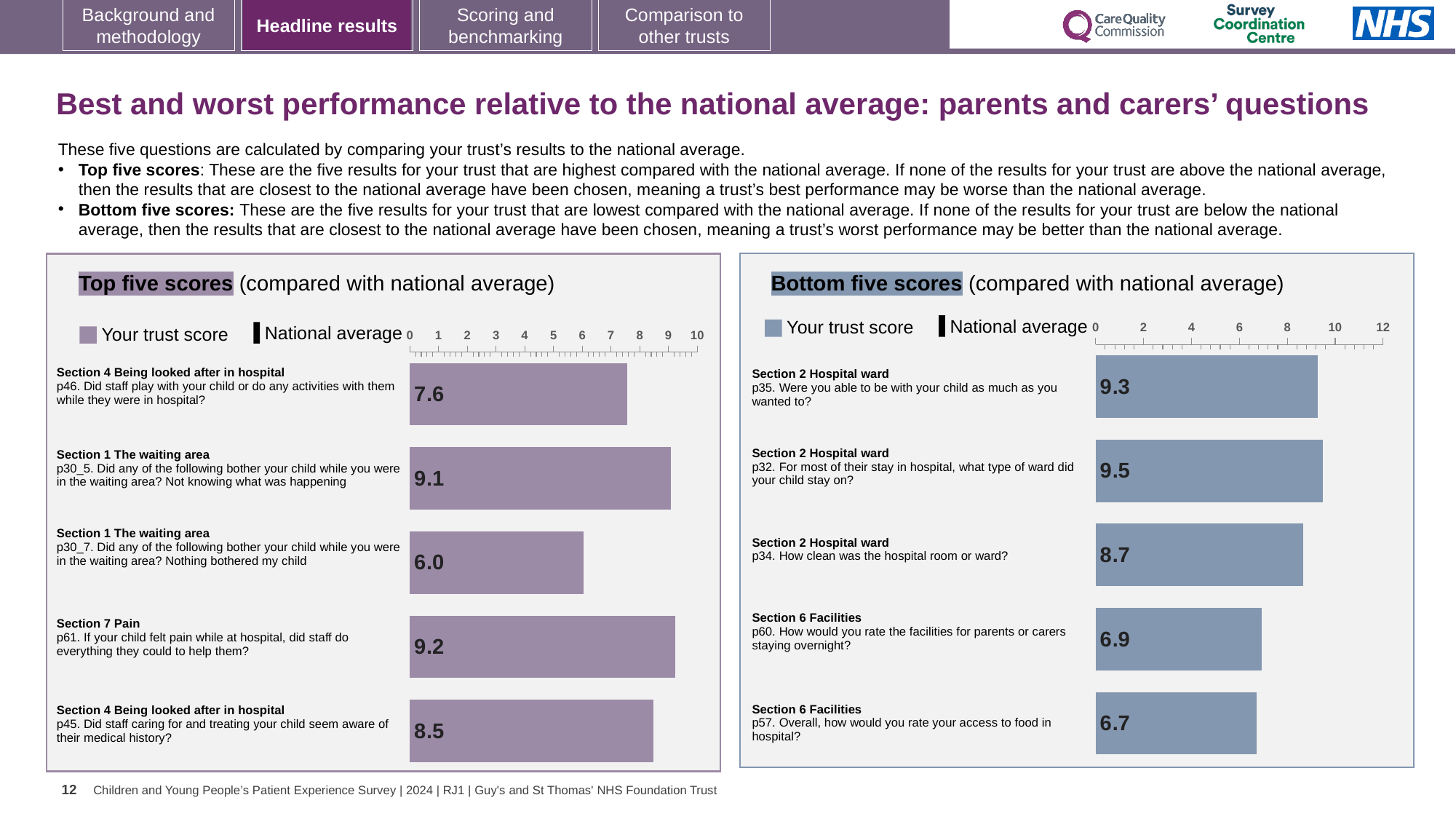
In the Bottom five scores chart, which question has the highest trust score? p32. For most of their stay in hospital, what type of ward did your child stay on? In the Bottom five scores chart, what is the difference between the trust scores for p32 and p57? 2.8 In the Bottom five scores chart, what is the trust score for p60 (How would you rate the facilities for parents or carers staying overnight)? 6.9 In the Top five scores chart, what is the trust score for p46 (Did staff play with your child or do any activities with them while they were in hospital)? 7.6 How many questions are plotted in the Top five scores chart? 5 In the Top five scores chart, which question has the lowest trust score? p30_7. Did any of the following bother your child while you were in the waiting area? Nothing bothered my child In the Top five scores chart, what is the difference between the trust scores for p61 and p30_7? 3.2 What type of chart is the Bottom five scores chart? Bar chart In the Bottom five scores chart, which question has the lowest trust score? p57. Overall, how would you rate your access to food in hospital? What is the maximum value shown on the axis of the Bottom five scores chart? 12 In the Bottom five scores chart, which has the higher trust score: p35 (Were you able to be with your child as much as you wanted to) or p34 (How clean was the hospital room or ward)? p35 In the Top five scores chart, which question has the highest trust score? p61. If your child felt pain while at hospital, did staff do everything they could to help them?